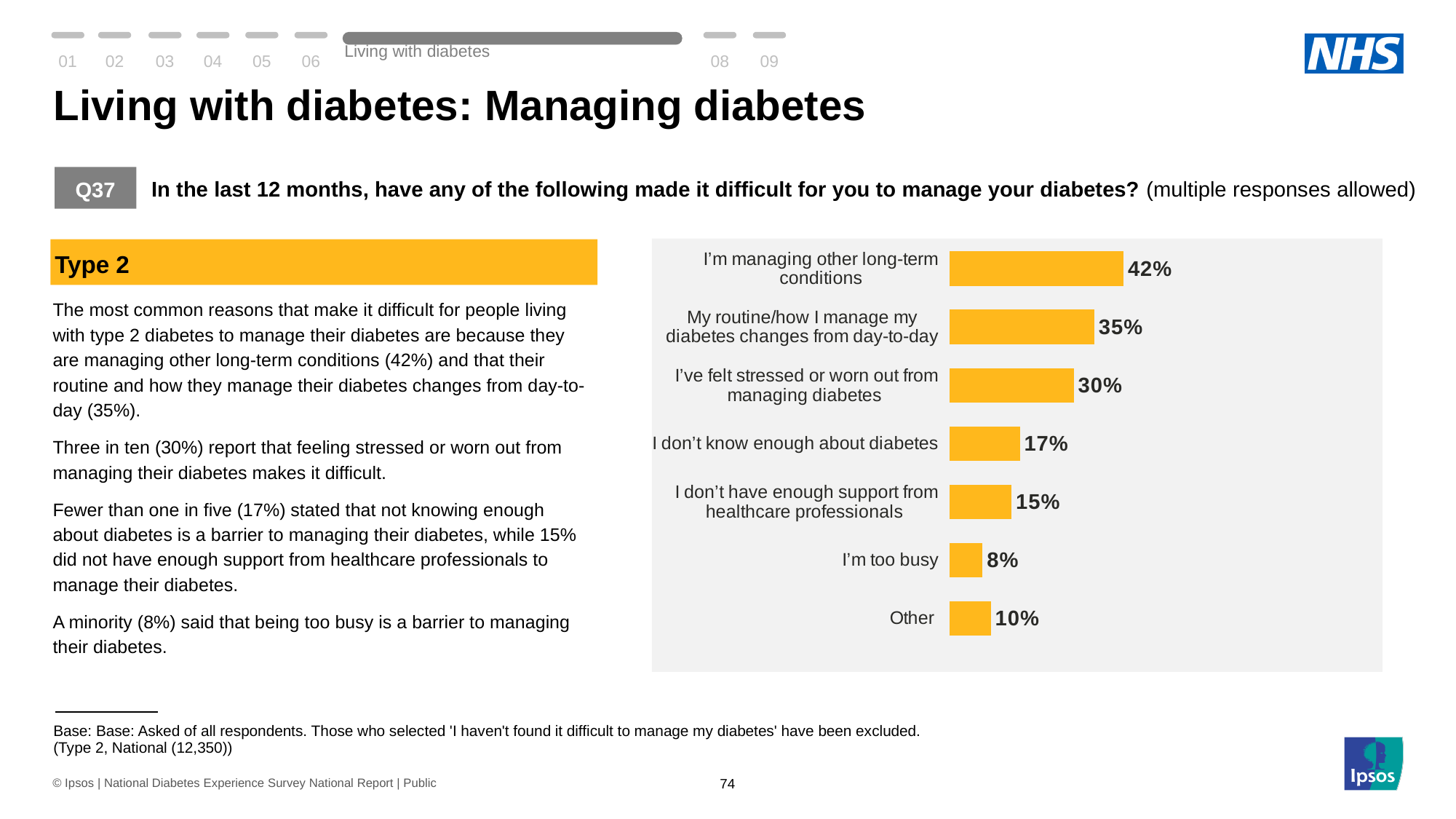
What colour are the bars in the chart? Orange/yellow What percentage of respondents said they don't have enough support from healthcare professionals? 15% What percentage of respondents said their routine/how they manage their diabetes changes from day-to-day? 35% What type of chart is shown on the slide? Bar chart Which reason has the lowest percentage in the chart? I'm too busy What percentage of respondents said they have felt stressed or worn out from managing diabetes? 30% Which reason has the highest percentage in the chart? I'm managing other long-term conditions What percentage of respondents said they are managing other long-term conditions? 42% What is the difference in percentage points between 'I'm managing other long-term conditions' and 'My routine/how I manage my diabetes changes from day-to-day'? 7 percentage points Which is larger: the percentage for 'I don't know enough about diabetes' or for 'I don't have enough support from healthcare professionals'? I don't know enough about diabetes What percentage of respondents selected 'Other'? 10% How many reasons (categories) are shown in the chart? 7